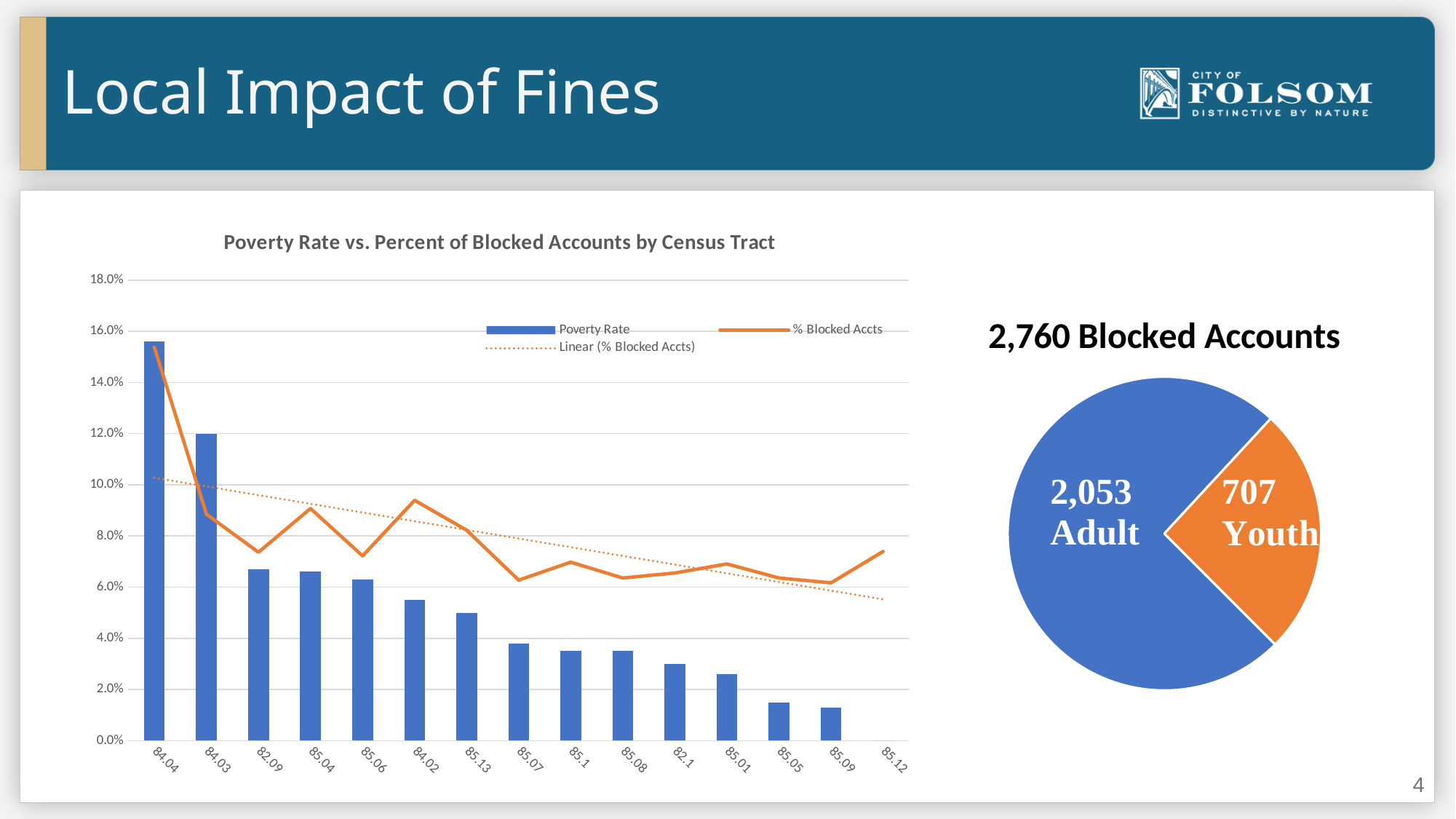
In the pie chart titled '2,760 Blocked Accounts', how many blocked accounts are Adult? 2,053 In the 'Poverty Rate vs. Percent of Blocked Accounts by Census Tract' chart, how many census tracts are listed on the x axis? 15 In the 'Poverty Rate vs. Percent of Blocked Accounts by Census Tract' chart, which has the higher poverty rate, tract 85.01 or tract 85.05? 85.01 In the 'Poverty Rate vs. Percent of Blocked Accounts by Census Tract' chart, is the poverty rate for tract 85.09 greater or less than 2.0%? less In the pie chart titled '2,760 Blocked Accounts', how many blocked accounts are Youth? 707 In the 'Poverty Rate vs. Percent of Blocked Accounts by Census Tract' chart, what colour is the % Blocked Accts line? Orange In the pie chart titled '2,760 Blocked Accounts', how many more Adult blocked accounts are there than Youth? 1,346 In the 'Poverty Rate vs. Percent of Blocked Accounts by Census Tract' chart, how many entries does the legend list? 3 In the 'Poverty Rate vs. Percent of Blocked Accounts by Census Tract' chart, which census tract has the highest poverty rate bar? 84.04 In the 'Poverty Rate vs. Percent of Blocked Accounts by Census Tract' chart, do the poverty rate bars rise or fall from left to right? fall In the 'Poverty Rate vs. Percent of Blocked Accounts by Census Tract' chart, is the poverty rate for tract 84.04 greater or less than 14.0%? greater What kind of chart is the one titled 'Poverty Rate vs. Percent of Blocked Accounts by Census Tract'? A bar chart combined with a line chart